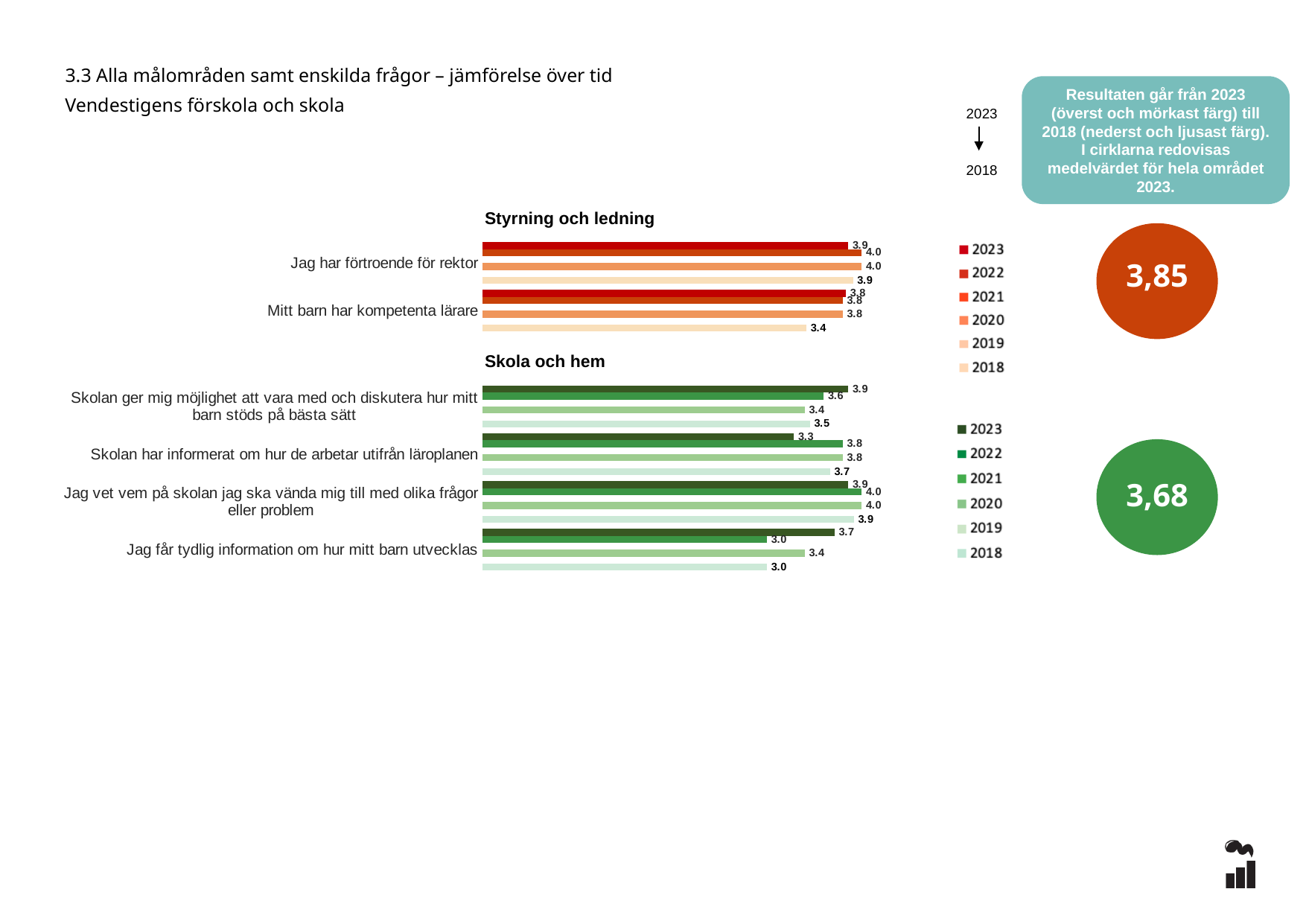
In the 'Skola och hem' chart, what is the value of the topmost (2023) bar for 'Jag får tydlig information om hur mitt barn utvecklas'? 3.7 In the 'Styrning och ledning' chart, how many question categories are plotted? 2 In the 'Skola och hem' chart, what is the difference between the topmost bar (3.9) and the bottom bar (3.5) for 'Skolan ger mig möjlighet att vara med och diskutera hur mitt barn stöds på bästa sätt'? 0.4 What kind of chart is used on this slide for 'Styrning och ledning' and 'Skola och hem'? Bar chart In the 'Skola och hem' chart, how many question categories are plotted? 4 In the 'Styrning och ledning' chart, how many entries does the legend list? 6 In the 'Skola och hem' chart, which category has the lowest topmost (2023) bar? Skolan har informerat om hur de arbetar utifrån läroplanen In the 'Styrning och ledning' chart, what is the value of the bottom (lightest) bar for 'Mitt barn har kompetenta lärare'? 3.4 What mean value for 2023 is shown in the orange circle next to the 'Styrning och ledning' chart? 3,85 In the 'Skola och hem' chart, what is the lowest value shown among the bars for 'Jag får tydlig information om hur mitt barn utvecklas'? 3.0 In the 'Styrning och ledning' chart, what is the value of the topmost (2023) bar for 'Jag har förtroende för rektor'? 3.9 In the 'Skola och hem' chart, which has the larger topmost (2023) bar: 'Skolan har informerat om hur de arbetar utifrån läroplanen' or 'Jag vet vem på skolan jag ska vända mig till med olika frågor eller problem'? Jag vet vem på skolan jag ska vända mig till med olika frågor eller problem